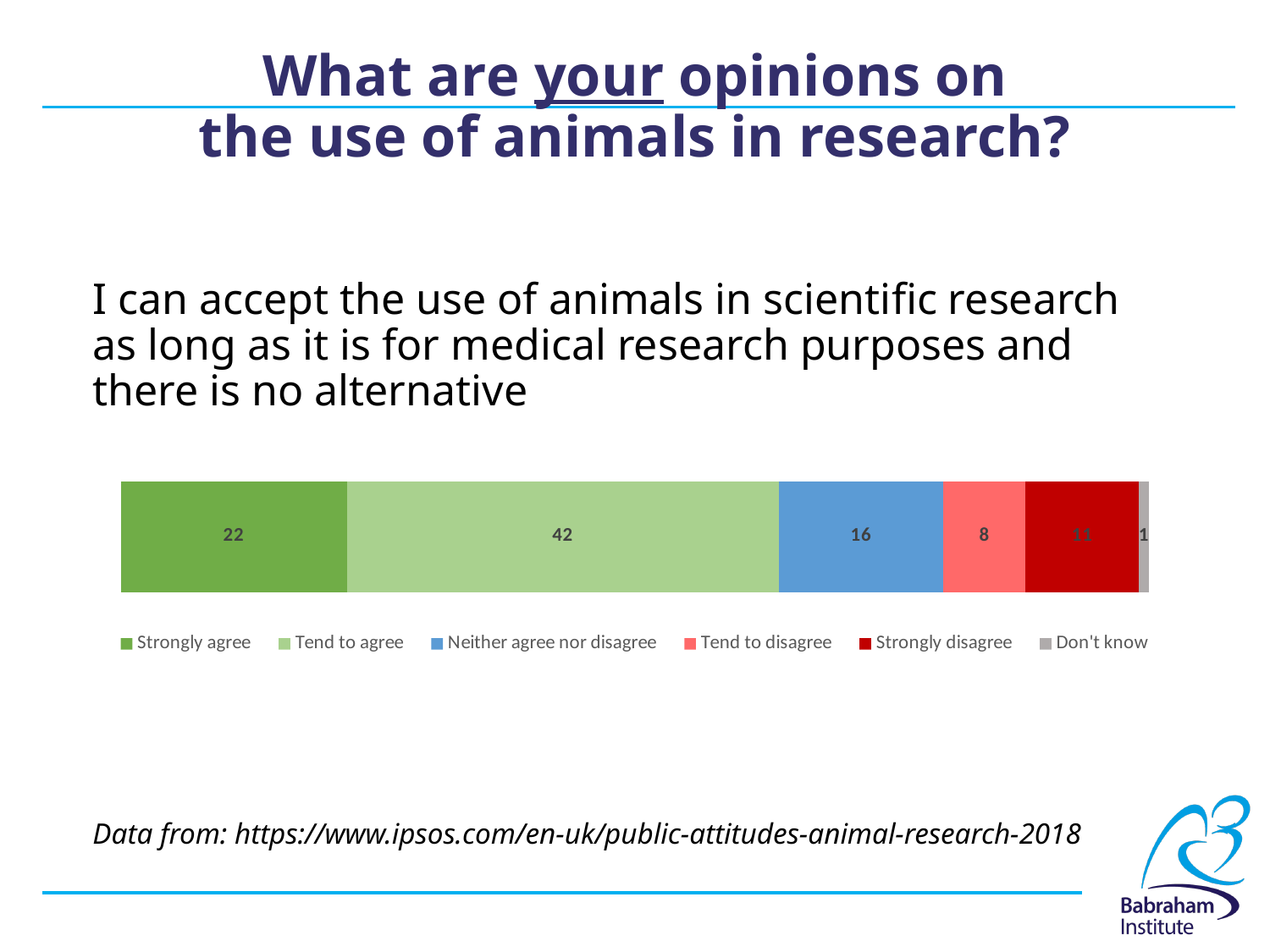
What is the value for Tend to agree? 42 What is the value for Tend to disagree? 8 What is the value for Strongly agree? 22 What is the difference between the values for Tend to agree and Strongly agree? 20 How many series does the legend list? 6 What is the value for Strongly disagree? 11 What is the value for Neither agree nor disagree? 16 Which is larger, the value for Strongly disagree or the value for Tend to disagree? Strongly disagree Which response has the lowest value? Don't know What is the total of the stacked bar? 100 Which response has the highest value? Tend to agree What kind of chart is shown on the slide? Stacked bar chart